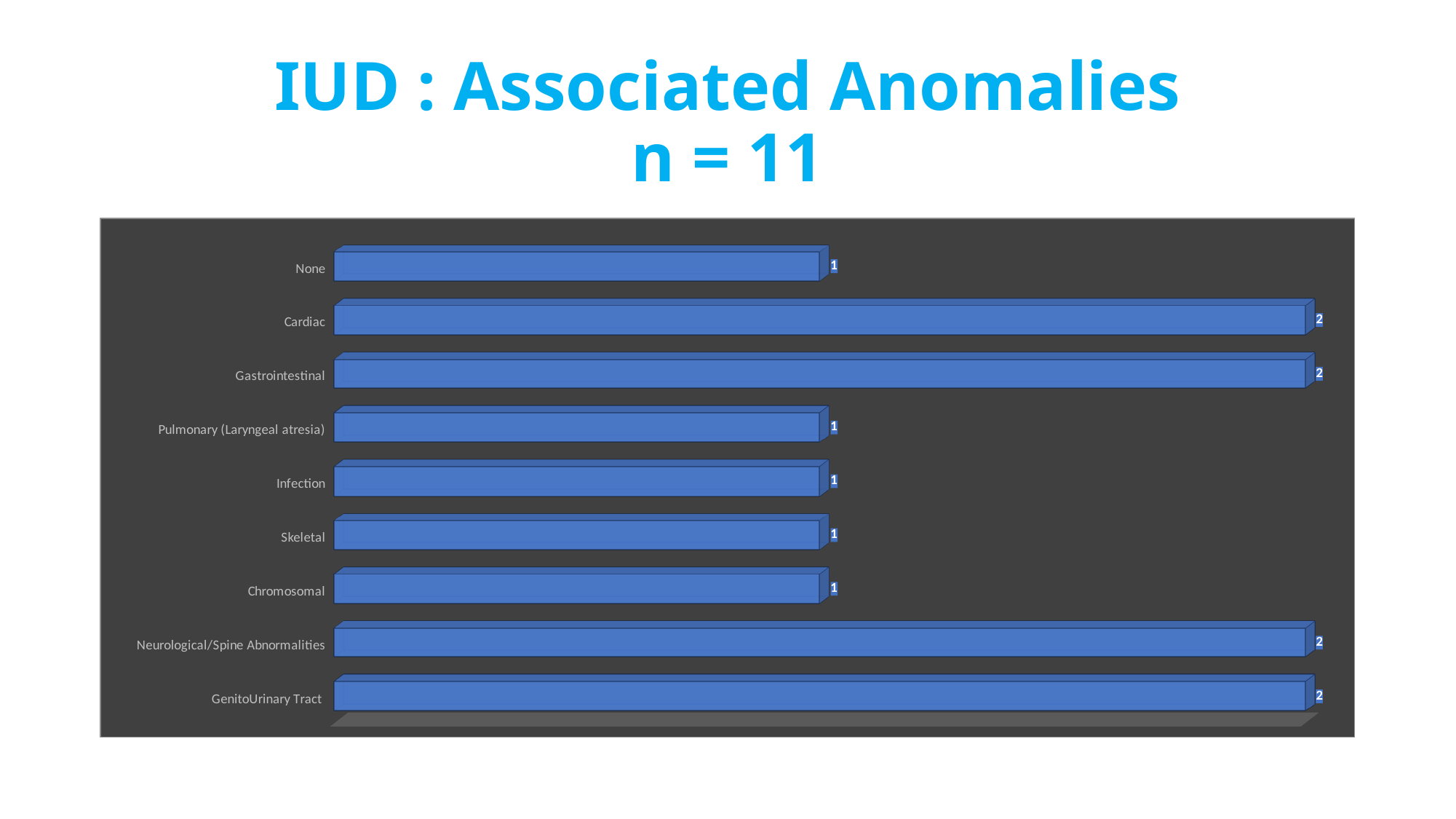
Which is larger, the value for Cardiac or the value for Chromosomal? Cardiac How many categories are shown in the chart? 9 What is the value for Chromosomal? 1 What is the title of the slide containing the chart? IUD : Associated Anomalies n = 11 What is the value for Pulmonary (Laryngeal atresia)? 1 Which is larger, the value for Neurological/Spine Abnormalities or the value for Infection? Neurological/Spine Abnormalities What is the value for None? 1 What colour are the bars in the chart? Blue What kind of chart is shown on the slide? Bar chart What is the value for GenitoUrinary Tract? 2 What is the value for Cardiac? 2 What is the difference between the values for Gastrointestinal and Skeletal? 1